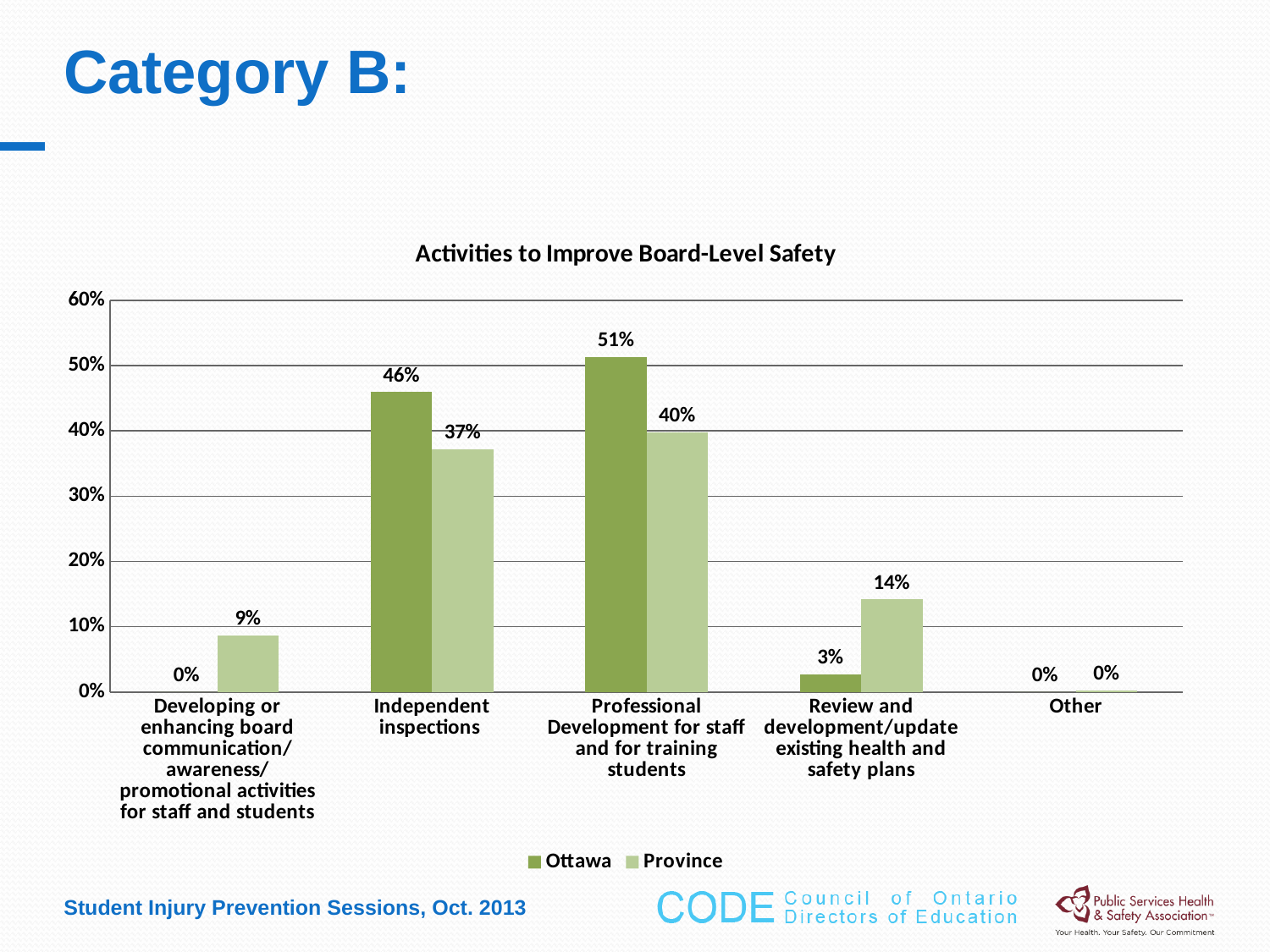
How many categories are shown on the x axis? 5 What is the Ottawa value for Independent inspections? 46% What kind of chart is shown? bar chart For Review and development/update existing health and safety plans, which is larger, the Ottawa value or the Province value? Province Is the Ottawa value for Independent inspections greater or less than 40%? greater What is the difference between the Ottawa and Province values for Professional Development for staff and for training students? 11% What is the Province value for Review and development/update existing health and safety plans? 14% Which category has the lowest Province value? Other What is the title of the chart? Activities to Improve Board-Level Safety Which category has the highest Ottawa value? Professional Development for staff and for training students What is the Province value for Developing or enhancing board communication/awareness/promotional activities for staff and students? 9% How many series does the legend list? 2